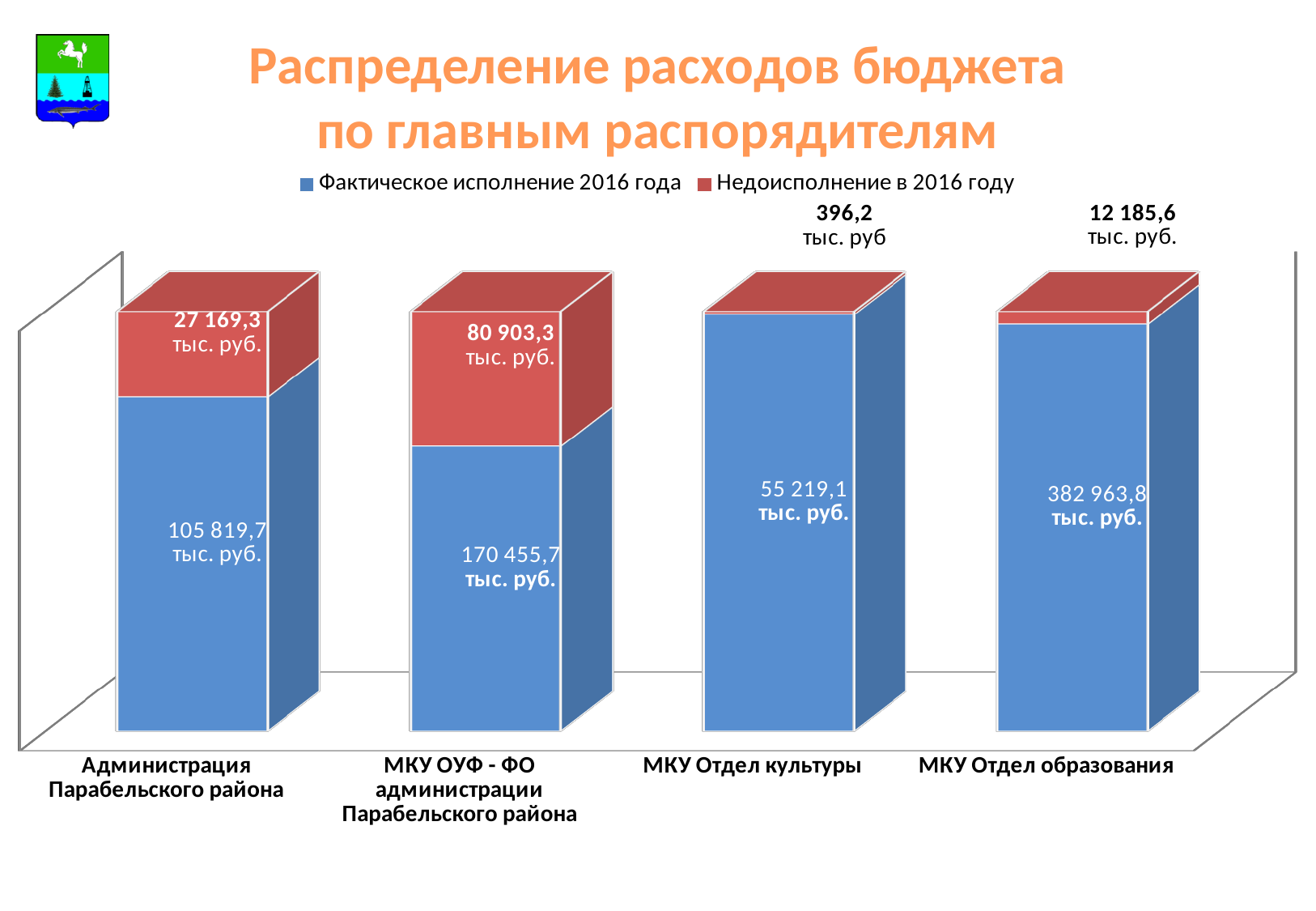
What is the value of "Фактическое исполнение 2016 года" for Администрация Парабельского района? 105 819,7 тыс. руб. Which category has the lowest value of "Недоисполнение в 2016 году"? МКУ Отдел культуры How many categories are shown on the x axis? 4 What is the value of "Фактическое исполнение 2016 года" for МКУ Отдел образования? 382 963,8 тыс. руб. What is the difference between the "Недоисполнение в 2016 году" values for МКУ ОУФ - ФО администрации Парабельского района and Администрация Парабельского района? 53 734,0 тыс. руб. What kind of chart is shown on the slide? Stacked bar chart Which is larger: "Фактическое исполнение 2016 года" for МКУ ОУФ - ФО администрации Парабельского района or for МКУ Отдел культуры? МКУ ОУФ - ФО администрации Парабельского района What is the value of "Недоисполнение в 2016 году" for МКУ Отдел культуры? 396,2 тыс. руб What is the value of "Недоисполнение в 2016 году" for МКУ ОУФ - ФО администрации Парабельского района? 80 903,3 тыс. руб. What is the total of the two series for Администрация Парабельского района? 132 989,0 тыс. руб. Which category has the highest value of "Фактическое исполнение 2016 года"? МКУ Отдел образования How many series does the legend list? 2